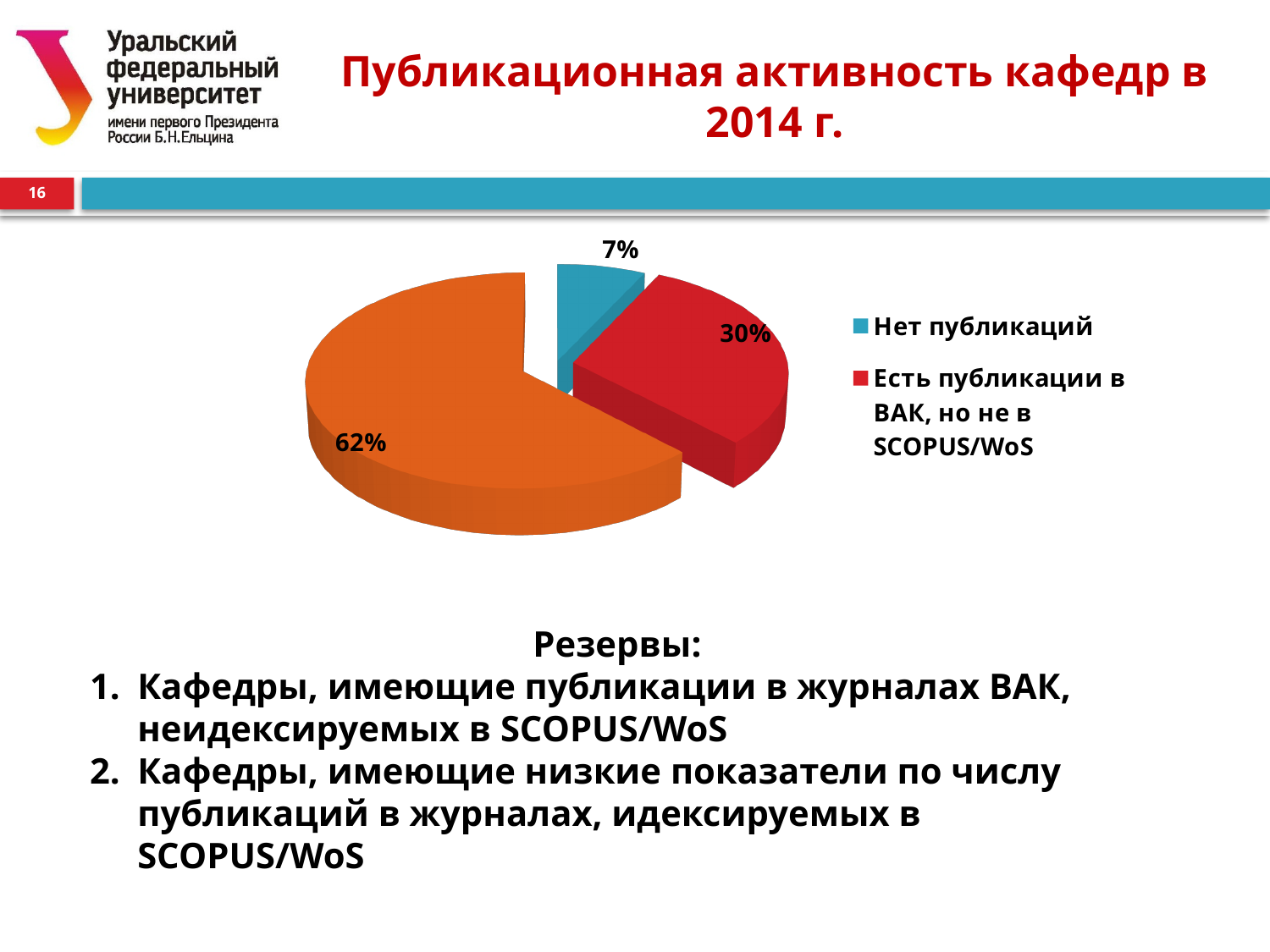
What is the value of the largest slice of the pie? 62% What is the title of the slide containing the pie chart? Публикационная активность кафедр в 2014 г. Which is larger: the "Нет публикаций" slice or the "Есть публикации в ВАК, но не в SCOPUS/WoS" slice? Есть публикации в ВАК, но не в SCOPUS/WoS What share of the pie does the orange slice represent? 62% What is the difference between the 62% slice and the 30% slice? 32 percentage points By how many percentage points does the "Есть публикации в ВАК, но не в SCOPUS/WoS" slice exceed the "Нет публикаций" slice? 23 percentage points What percentage of the pie is labelled "Есть публикации в ВАК, но не в SCOPUS/WoS"? 30% Which legend category has the smallest slice of the pie? Нет публикаций What kind of chart is shown on the slide? pie chart What colour is the "Нет публикаций" slice in the pie chart? blue What percentage of the pie is labelled "Нет публикаций"? 7% How many slices does the pie chart have? 3